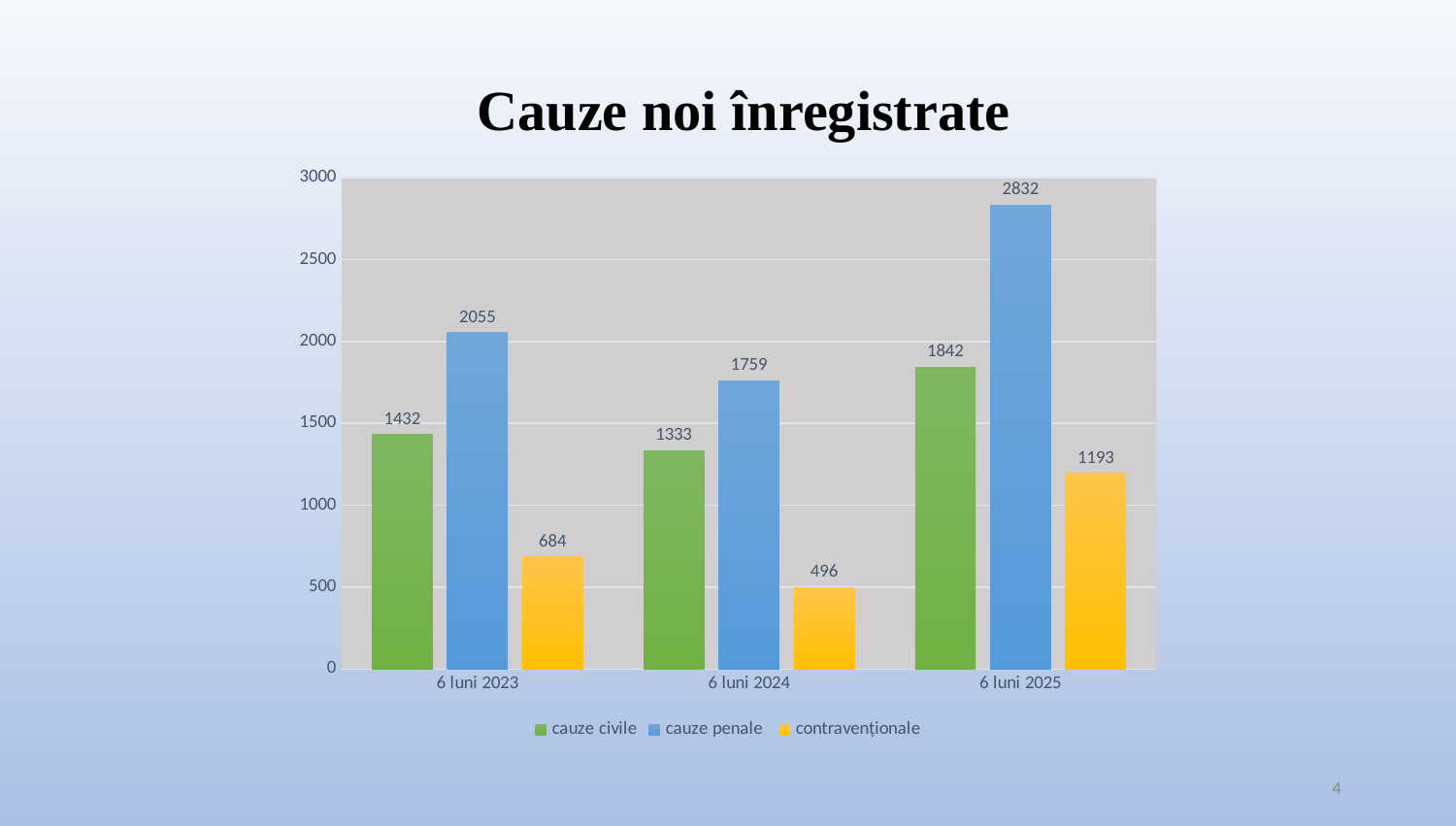
What kind of chart is shown on the slide? bar chart How many periods are shown on the x axis? 3 Which period has the highest value for cauze penale? 6 luni 2025 Which period has the lowest value for contravenționale? 6 luni 2024 What is the value for cauze civile in 6 luni 2023? 1432 What is the value for cauze penale in 6 luni 2025? 2832 How many series does the legend list? 3 What is the difference between cauze penale and cauze civile in 6 luni 2025? 990 Is the value for cauze civile in 6 luni 2025 greater or less than 1500? greater What is the value for contravenționale in 6 luni 2024? 496 Which is larger in 6 luni 2024: cauze civile or cauze penale? cauze penale What is the title of the chart? Cauze noi înregistrate